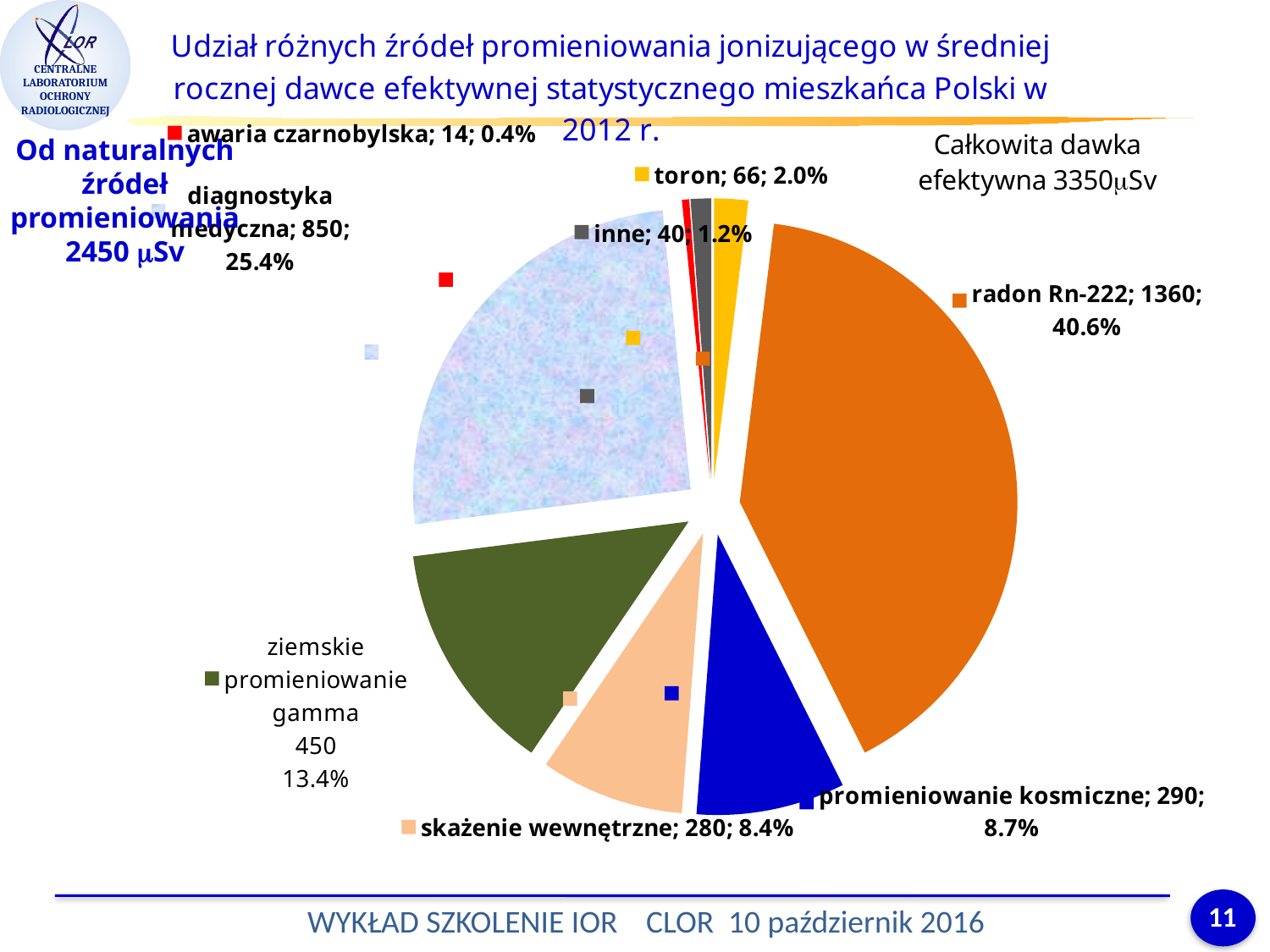
Which category has the largest slice of the pie? radon Rn-222 What is the difference between the values for radon Rn-222 and diagnostyka medyczna? 510 How many slices does the pie chart have? 8 What value is shown for promieniowanie kosmiczne? 290 What total effective dose (Całkowita dawka efektywna) is stated next to the chart? 3350 µSv What percentage share is shown for diagnostyka medyczna? 25.4% Which is larger, the value for toron or the value for inne? toron What percentage share is shown for ziemskie promieniowanie gamma? 13.4% What percentage share is shown for skażenie wewnętrzne? 8.4% Which category has the smallest slice of the pie? awaria czarnobylska What kind of chart is shown on the slide? pie chart What value is shown for radon Rn-222? 1360